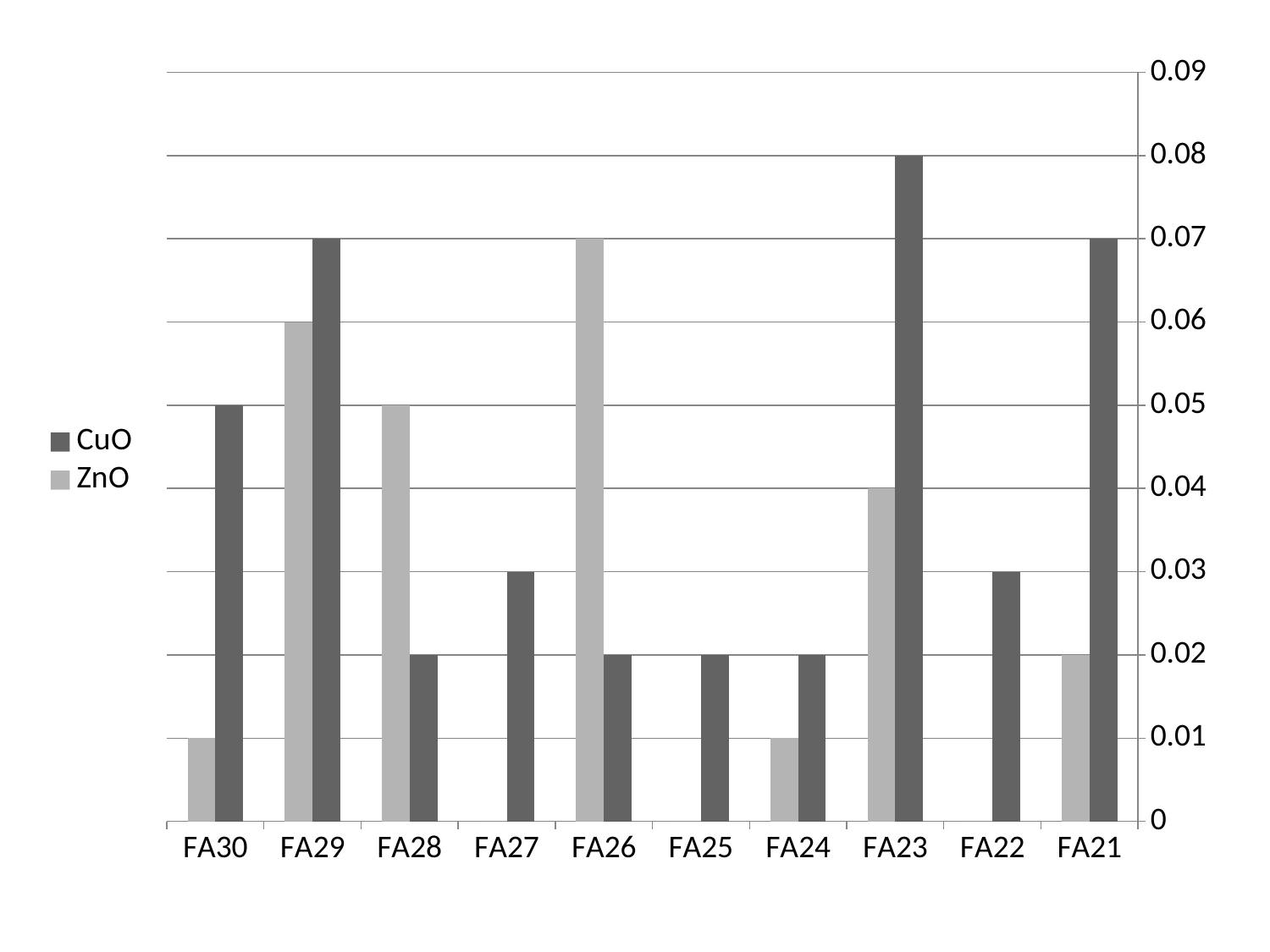
What is the CuO value for FA30? 0.05 Which is larger for FA28, the CuO value or the ZnO value? ZnO What is the CuO value for FA23? 0.08 What type of chart is shown on the slide? bar chart How many categories are shown on the x axis? 10 What is the ZnO value for FA28? 0.05 Which category has the highest ZnO value? FA26 What is the ZnO value for FA26? 0.07 How many series does the legend list? 2 Which series is shown in the darker grey colour? CuO What is the difference between the CuO and ZnO values for FA30? 0.04 Which category has the highest CuO value? FA23